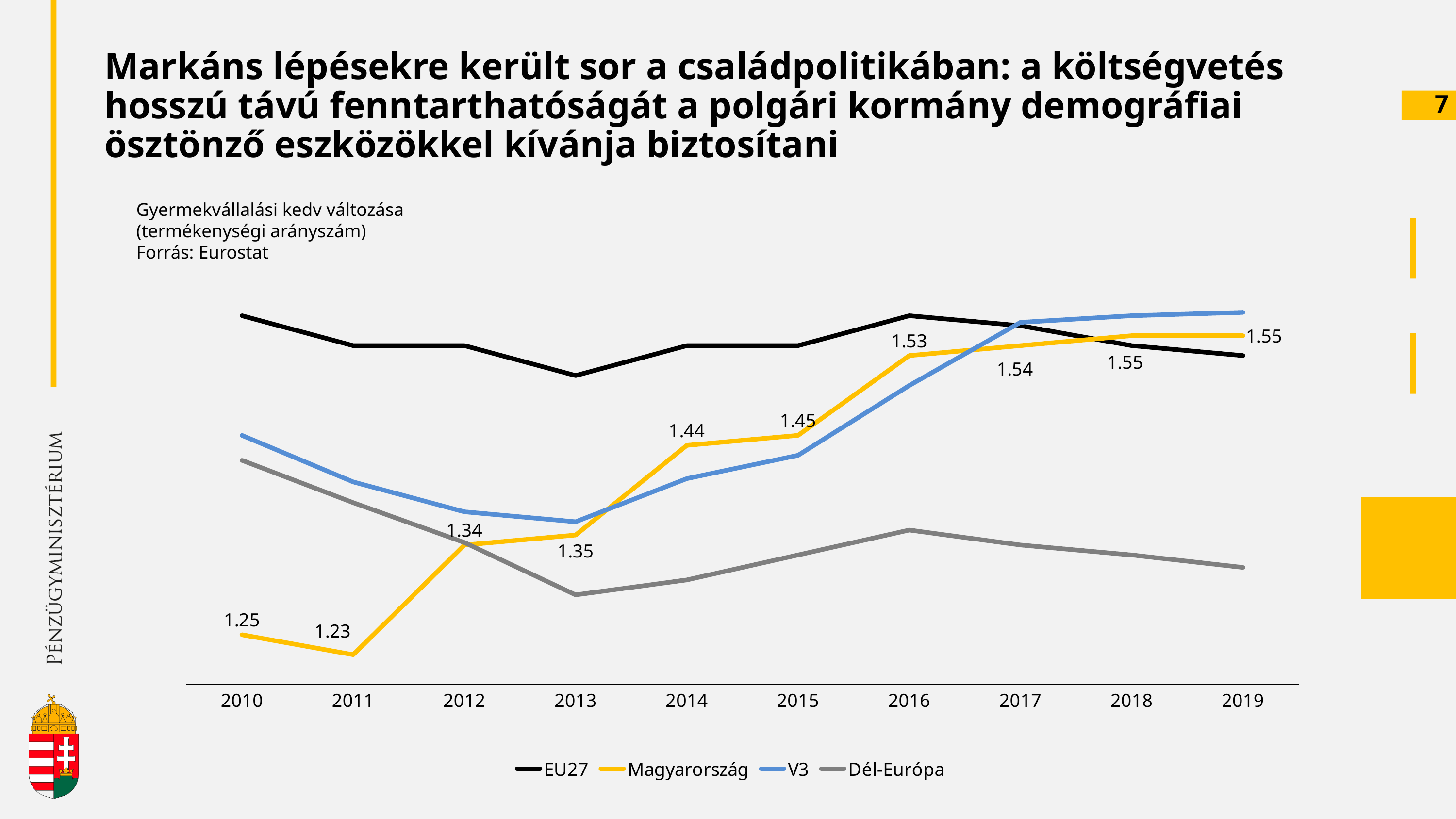
Which is larger for Magyarország: the value in 2013 or in 2014? 2014 What is the difference between the Magyarország values in 2019 and 2010? 0.30 How many years are shown on the x axis? 10 What is the value for Magyarország in 2016? 1.53 What is the value for Magyarország in 2019? 1.55 How many series does the legend list? 4 What type of chart is shown on the slide? line chart What source is cited for the chart data? Eurostat What is the value for Magyarország in 2010? 1.25 Does the Magyarország series rise or fall from 2011 to 2019? rise In which year is the Magyarország series at its lowest? 2011 In 2010, which series is higher: EU27 or Magyarország? EU27